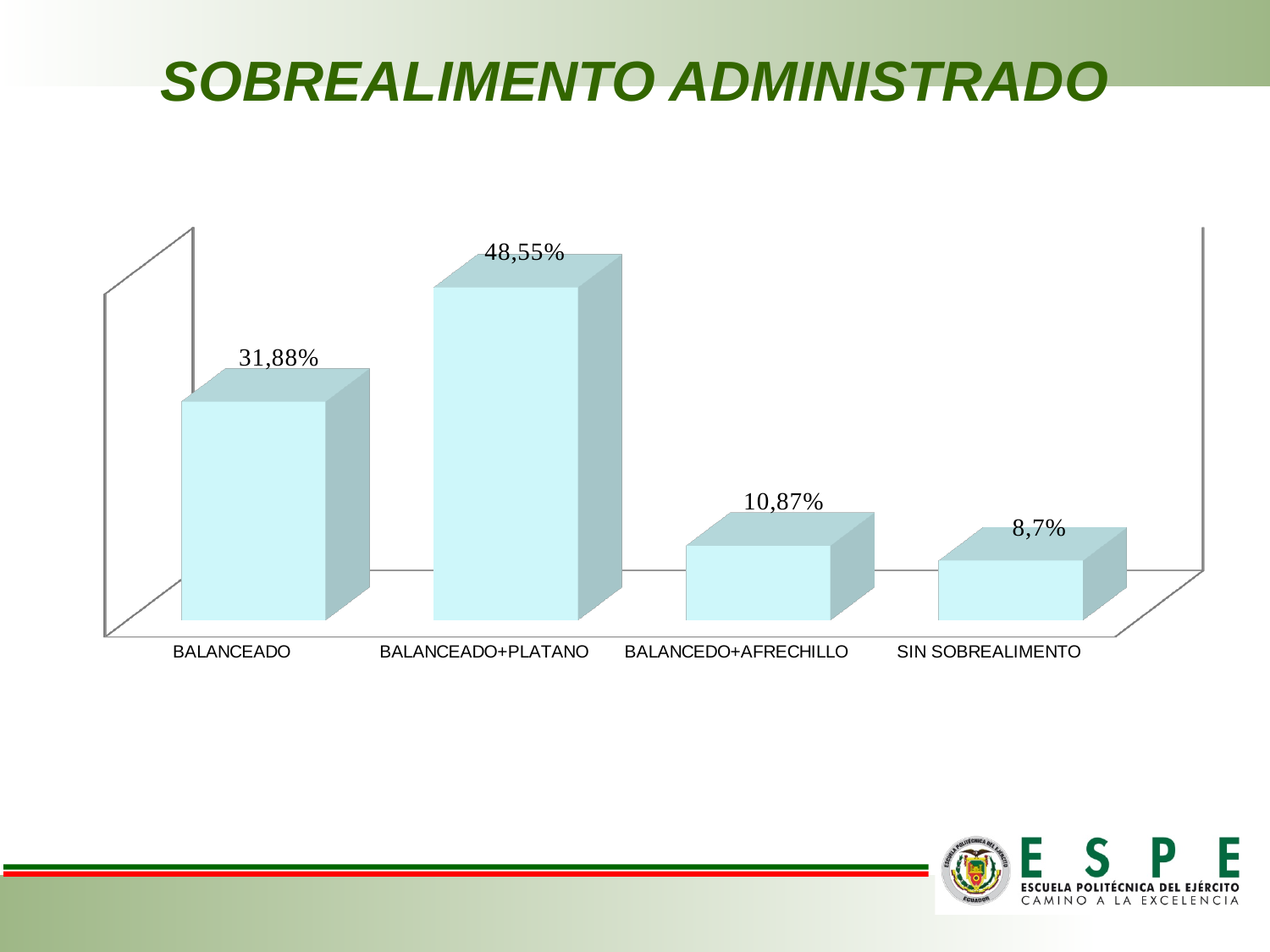
What is the title of the slide? SOBREALIMENTO ADMINISTRADO Which is larger, the value for BALANCEADO or the value for BALANCEDO+AFRECHILLO? BALANCEADO How many categories are shown in the chart? 4 Which category has the lowest value? SIN SOBREALIMENTO What is the value for BALANCEADO? 31,88% What is the value for SIN SOBREALIMENTO? 8,7% What is the difference between the values for BALANCEDO+AFRECHILLO and SIN SOBREALIMENTO? 2,17% What is the value for BALANCEADO+PLATANO? 48,55% Which category has the highest value? BALANCEADO+PLATANO What is the value for BALANCEDO+AFRECHILLO? 10,87% What is the difference between the values for BALANCEADO+PLATANO and BALANCEADO? 16,67% What kind of chart is shown on the slide? bar chart